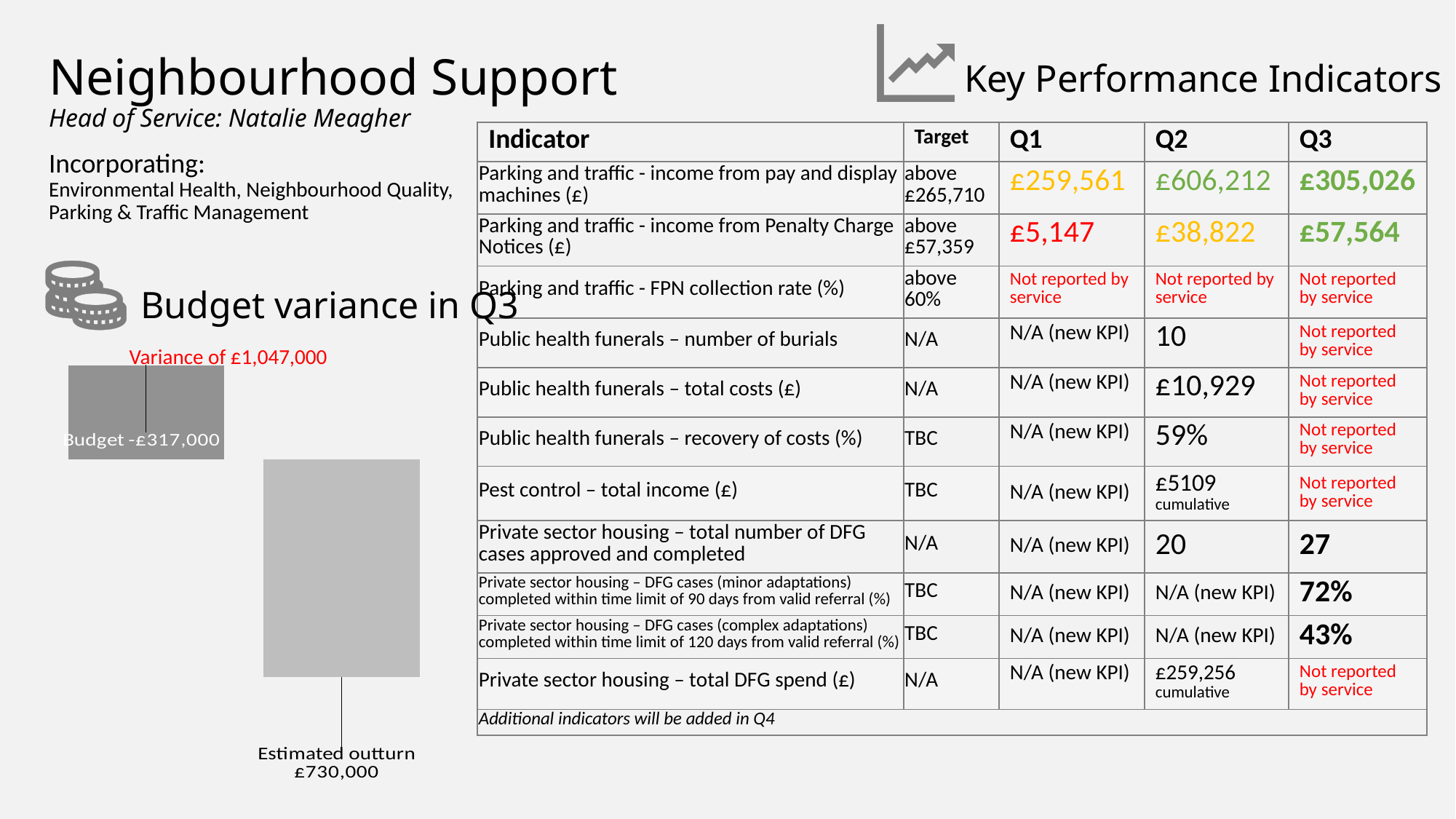
On the Budget variance in Q3 chart, which bar has the higher value? Estimated outturn On the Budget variance in Q3 chart, what is the value shown for Estimated outturn? £730,000 On the Budget variance in Q3 chart, which bar has the lower value? Budget What variance is stated in the red label above the Budget variance in Q3 chart? Variance of £1,047,000 On the Budget variance in Q3 chart, is the Budget value positive or negative? Negative On the Budget variance in Q3 chart, which is larger: the Budget or the Estimated outturn? Estimated outturn How many bars are plotted on the Budget variance in Q3 chart? 2 What is the title of the chart on the left of the slide? Budget variance in Q3 On the Budget variance in Q3 chart, what is the difference between the Estimated outturn and the Budget? £1,047,000 On the Budget variance in Q3 chart, what is the value shown for Budget? -£317,000 What type of chart is the Budget variance in Q3 chart? Bar chart